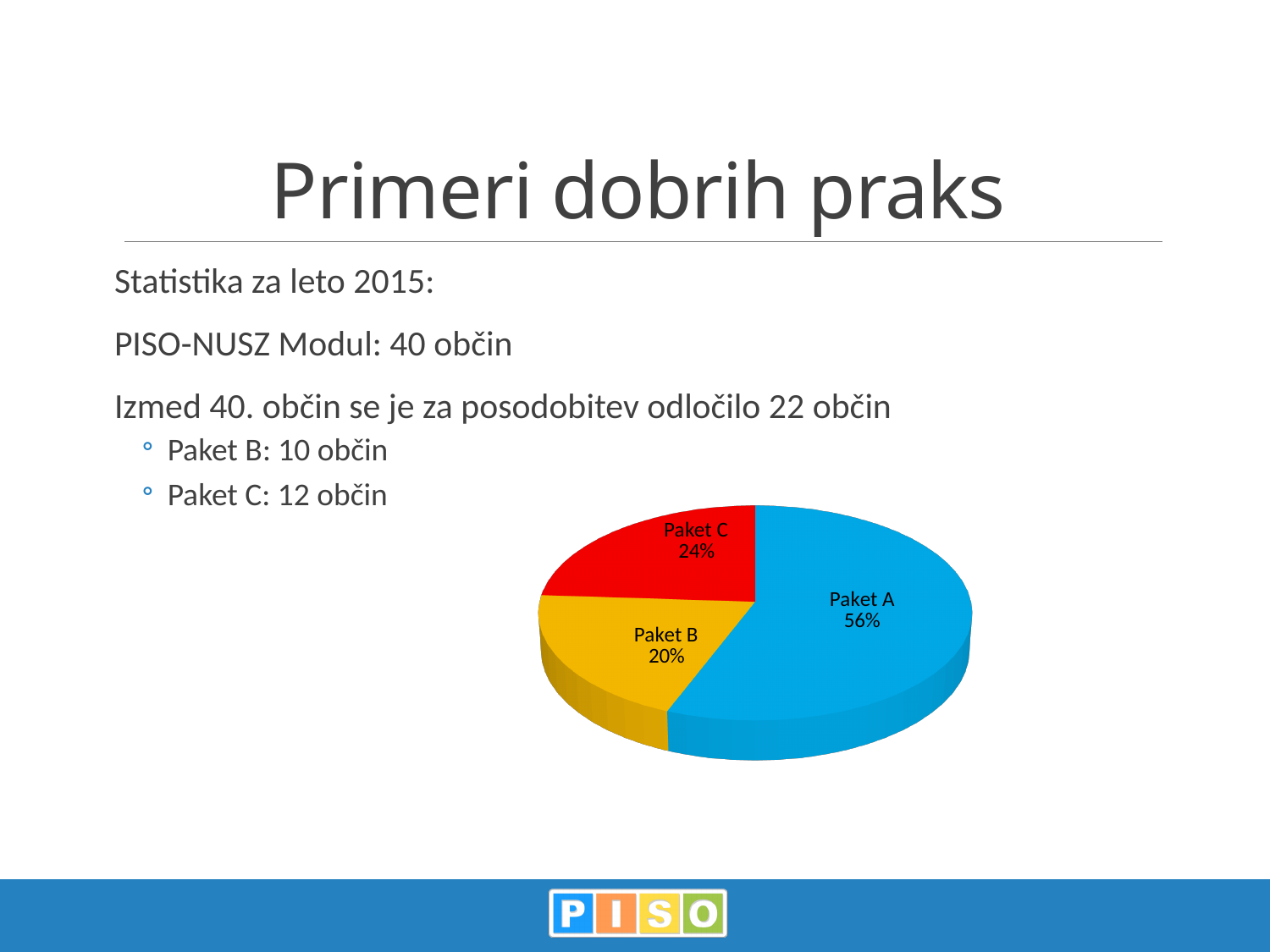
What share of the pie does Paket B represent? 20% What share of the pie does Paket A represent? 56% How many slices does the pie chart have? 3 What kind of chart is shown on the slide? pie chart What colour is the Paket C slice? red Which slice of the pie chart is the smallest? Paket B What is the difference in percentage points between Paket C and Paket B? 4 What colour is the Paket A slice? blue What is the difference in percentage points between Paket A and Paket C? 32 What share of the pie does Paket C represent? 24% Which slice of the pie chart is the largest? Paket A Which is larger, the share for Paket B or the share for Paket C? Paket C